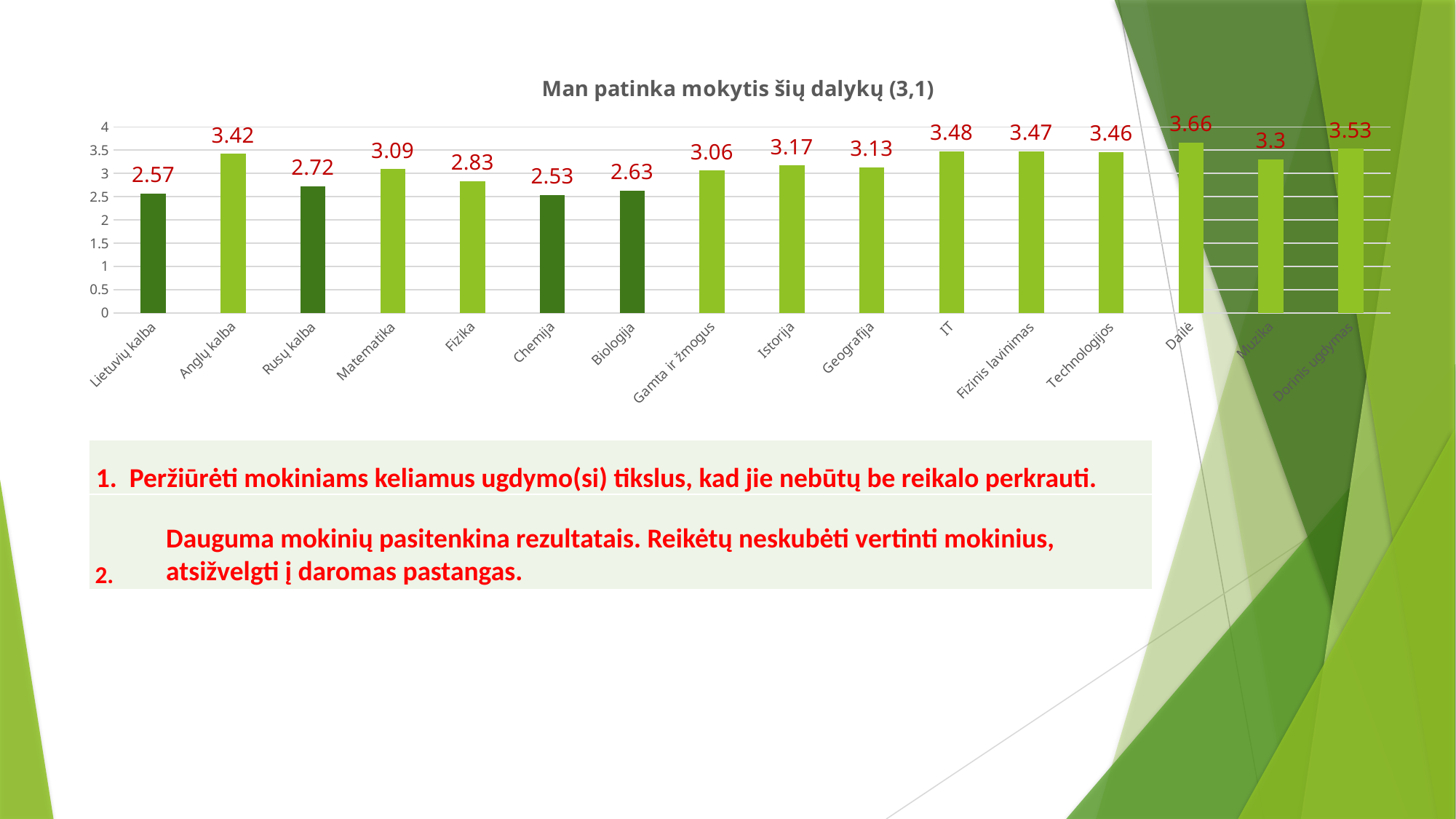
What is the value for Lietuvių kalba? 2.57 Which subject has the highest value? Dailė What is the value for Dorinis ugdymas? 3.53 What kind of chart is shown on the slide? Bar chart Which subject has the lowest value? Chemija What is the value for Gamta ir žmogus? 3.06 How many subjects are shown on the x axis? 16 What is the title of the chart? Man patinka mokytis šių dalykų (3,1) What is the difference between the values for Dailė and Chemija? 1.13 Is the value for Fizika greater or less than 3? less What is the difference between the values for Anglų kalba and Lietuvių kalba? 0.85 Which has a larger value, Matematika or Fizika? Matematika